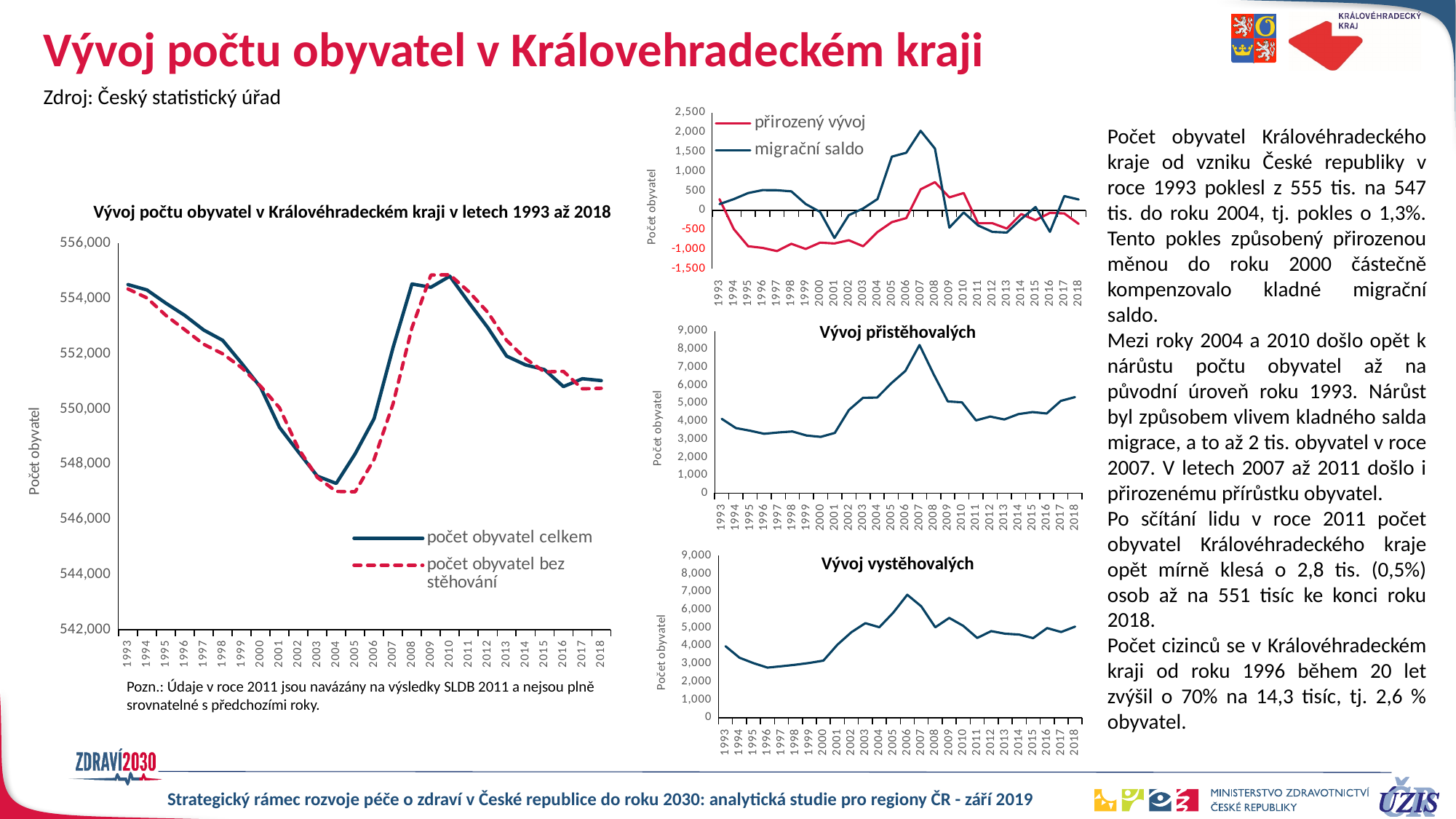
In the top-right chart with the series 'přirozený vývoj' and 'migrační saldo', is the value of 'přirozený vývoj' in 1995 greater or less than -500? less In the chart 'Vývoj počtu obyvatel v Královéhradeckém kraji v letech 1993 až 2018', in which year is 'počet obyvatel celkem' lowest? 2004 What are the two legend entries of the top-right chart (the one with the y axis from -1,500 to 2,500)? přirozený vývoj and migrační saldo In the top-right chart with the series 'přirozený vývoj' and 'migrační saldo', in which year is 'migrační saldo' highest? 2007 How many series does the legend of the chart 'Vývoj počtu obyvatel v Královéhradeckém kraji v letech 1993 až 2018' list? 2 In the chart 'Vývoj počtu obyvatel v Královéhradeckém kraji v letech 1993 až 2018', is the value of 'počet obyvatel celkem' in 2010 greater or less than 554,000? greater How many years are shown on the x axis of the chart 'Vývoj přistěhovalých'? 26 In the chart 'Vývoj počtu obyvatel v Královéhradeckém kraji v letech 1993 až 2018', is the value of 'počet obyvatel celkem' in 2004 greater or less than 548,000? less In the chart 'Vývoj vystěhovalých', in which year is the value highest? 2006 What kind of chart is the chart titled 'Vývoj počtu obyvatel v Královéhradeckém kraji v letech 1993 až 2018'? line chart In the chart 'Vývoj přistěhovalých', do the values rise or fall between 2001 and 2007? rise In the chart 'Vývoj přistěhovalých', in which year is the value highest? 2007